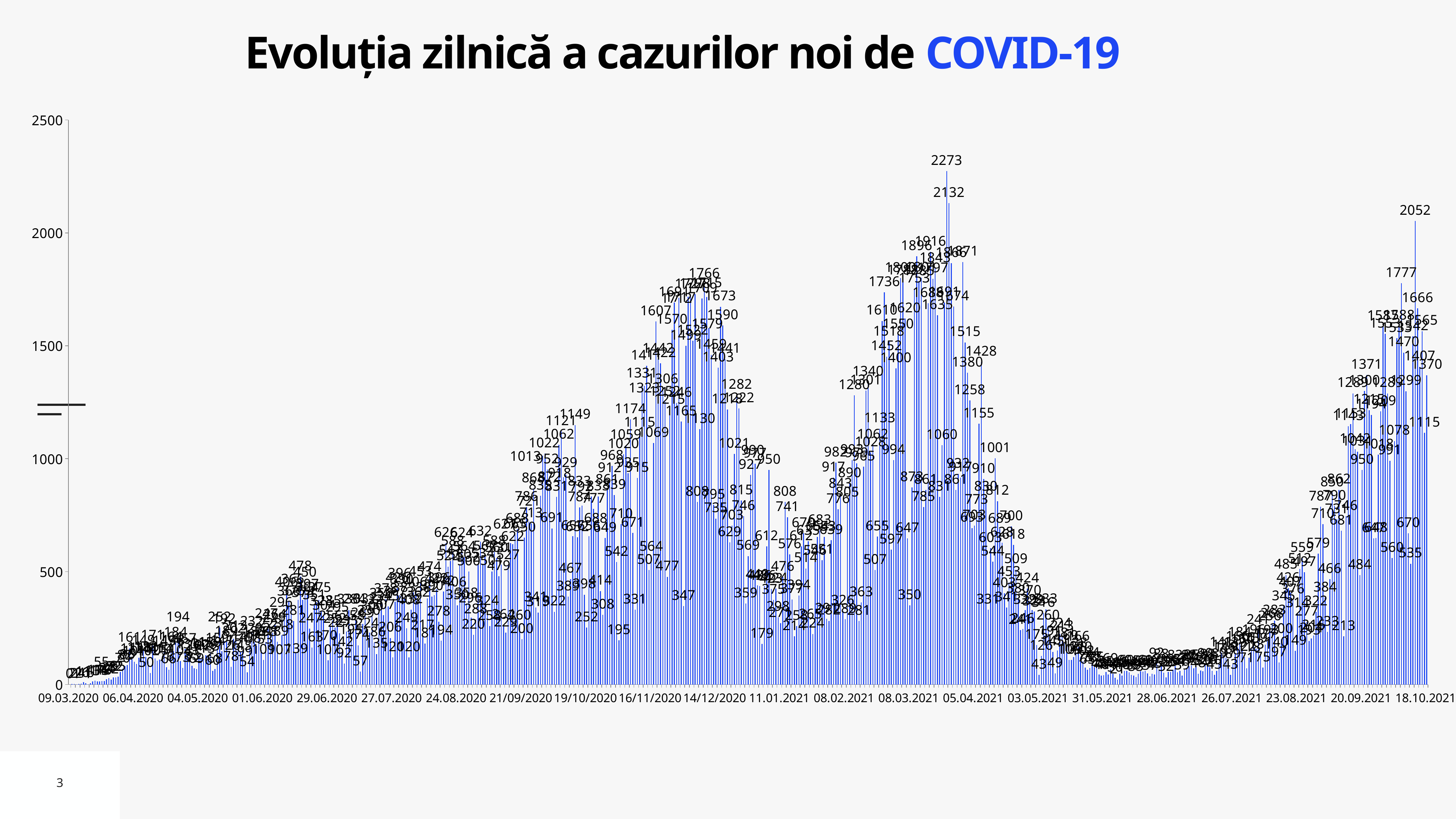
What is the second-highest value labelled on the chart? 2132 Do the values rise or fall between 26.07.2021 and 18.10.2021? rise What is the highest value labelled on the chart? 2273 Are the values around 31.05.2021 greater or less than 500? less Are the values around 18.10.2021 greater or less than 1000? greater What is the difference between the highest labelled value (2273) and the peak labelled 2052 near the end of the chart? 221 What is the title of the chart? Evoluția zilnică a cazurilor noi de COVID-19 What kind of chart is shown on the slide? bar chart Do the values rise or fall between 05.04.2021 and 31.05.2021? fall What is the highest value shown on the vertical axis? 2500 Which is larger: the peak labelled 2273 around 05.04.2021 or the peak labelled 2052 around 18.10.2021? 2273 Are the values around 09.03.2020 greater or less than 500? less